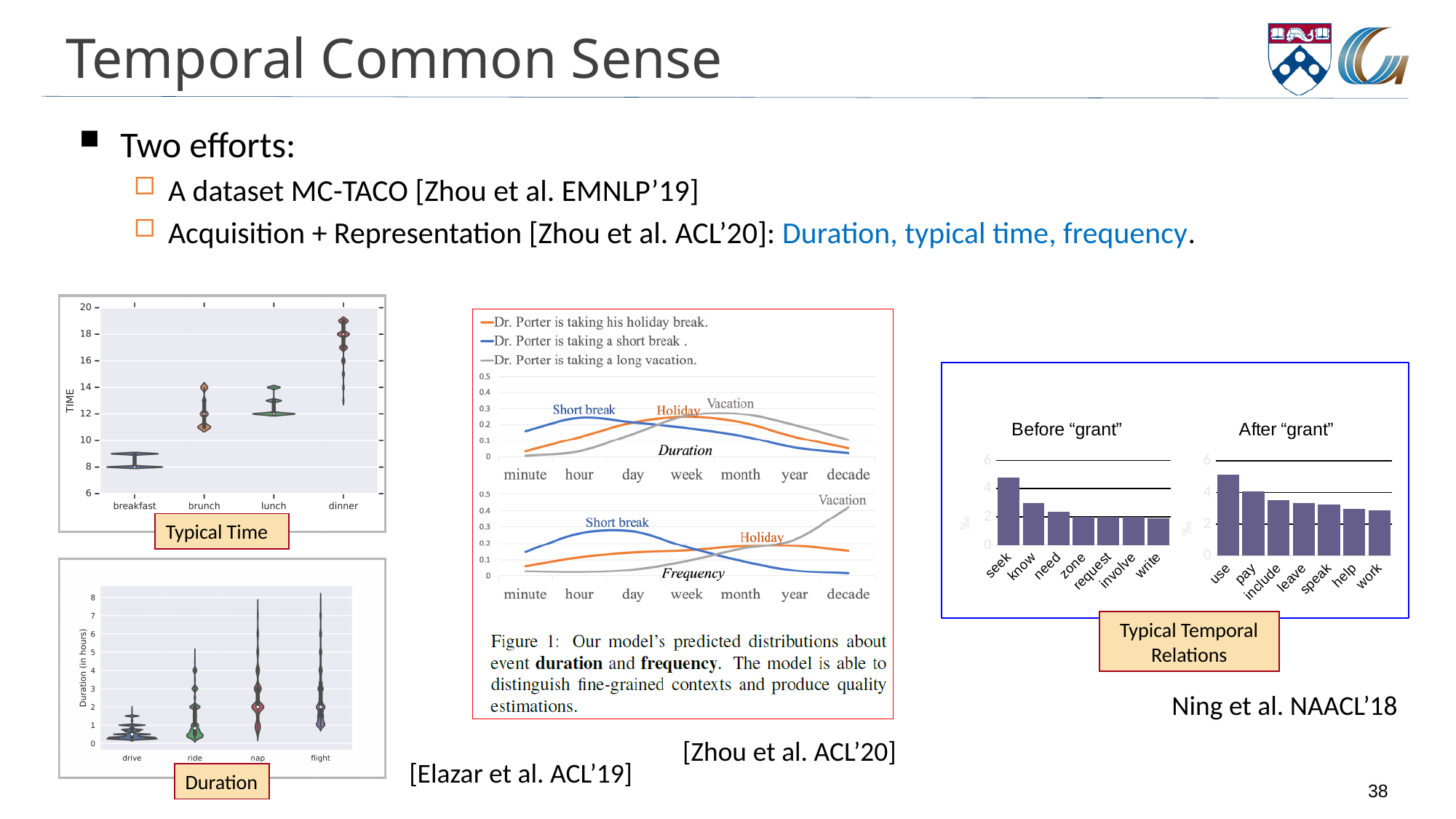
How many categories are shown on the x axis of the Duration violin chart (bottom left)? 4 How many categories are shown in the Before "grant" bar chart? 7 In the Before "grant" bar chart, which category has the highest value? seek In the After "grant" bar chart, do the values rise or fall from left to right? fall How many categories are shown in the After "grant" bar chart? 7 In the Typical Time chart, which meal has the highest typical time? dinner In the After "grant" bar chart, which category has the highest value? use In the Before "grant" bar chart, is the value for seek greater or less than 4? greater In the After "grant" bar chart, is the value for work greater or less than 4? less In the Before "grant" bar chart, which is larger, the value for seek or the value for know? seek What kind of chart is the Before "grant" chart? bar chart How many series does the legend of the Figure 1 line chart (center) list? 3